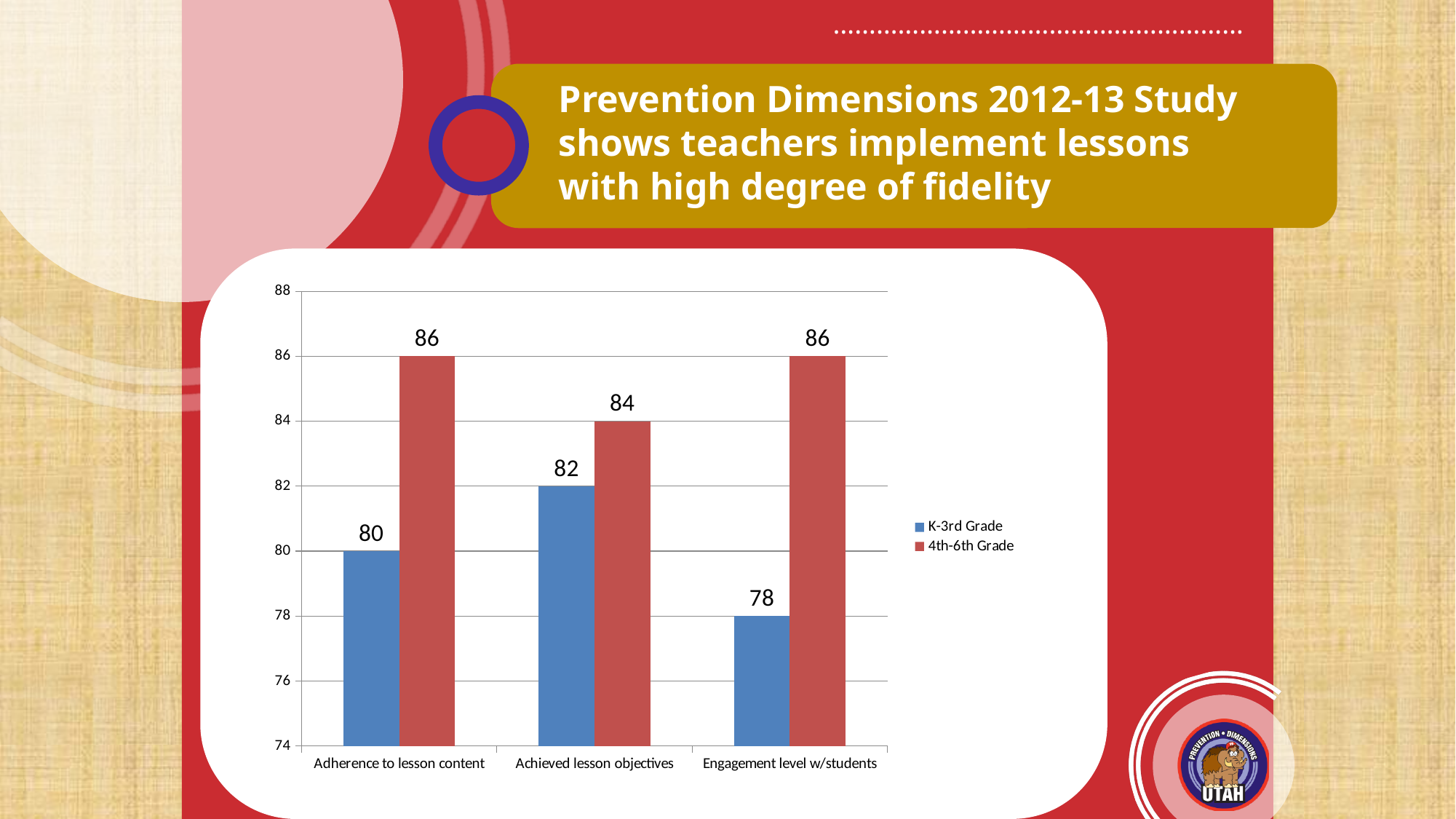
What kind of chart is shown on the slide? Bar chart What is the value for K-3rd Grade on Engagement level w/students? 78 How many categories are shown on the x axis? 3 Which category has the highest value for K-3rd Grade? Achieved lesson objectives How many series does the legend list? 2 What is the value for K-3rd Grade on Adherence to lesson content? 80 What is the value for 4th-6th Grade on Achieved lesson objectives? 84 Which category has the lowest value for 4th-6th Grade? Achieved lesson objectives What is the value for 4th-6th Grade on Engagement level w/students? 86 Which category has the lowest value for K-3rd Grade? Engagement level w/students What is the difference between the 4th-6th Grade and K-3rd Grade values for Engagement level w/students? 8 Which series has the larger value for Achieved lesson objectives, K-3rd Grade or 4th-6th Grade? 4th-6th Grade